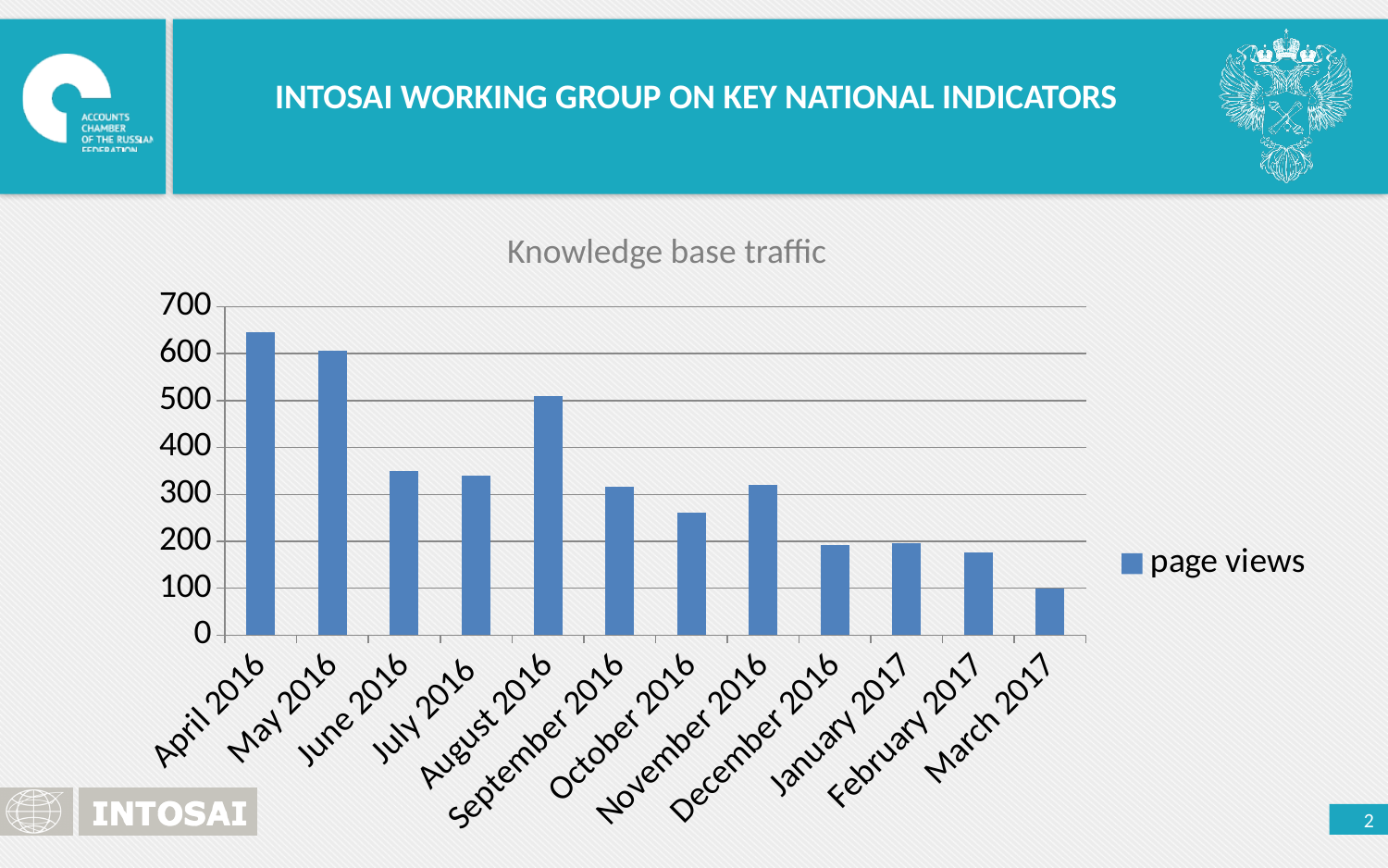
Is the value for August 2016 greater or less than 400? greater What type of chart is shown on the slide? bar chart How many months are shown on the x axis? 12 How many series does the legend list? 1 Which month has the highest number of page views? April 2016 Which has more page views, August 2016 or June 2016? August 2016 Is the value for October 2016 greater or less than 300? less What is the title of the chart? Knowledge base traffic What is the name of the series shown in the legend? page views Is the value for April 2016 greater or less than 600? greater Do page views generally rise or fall from April 2016 to March 2017? fall Which month has the lowest number of page views? March 2017